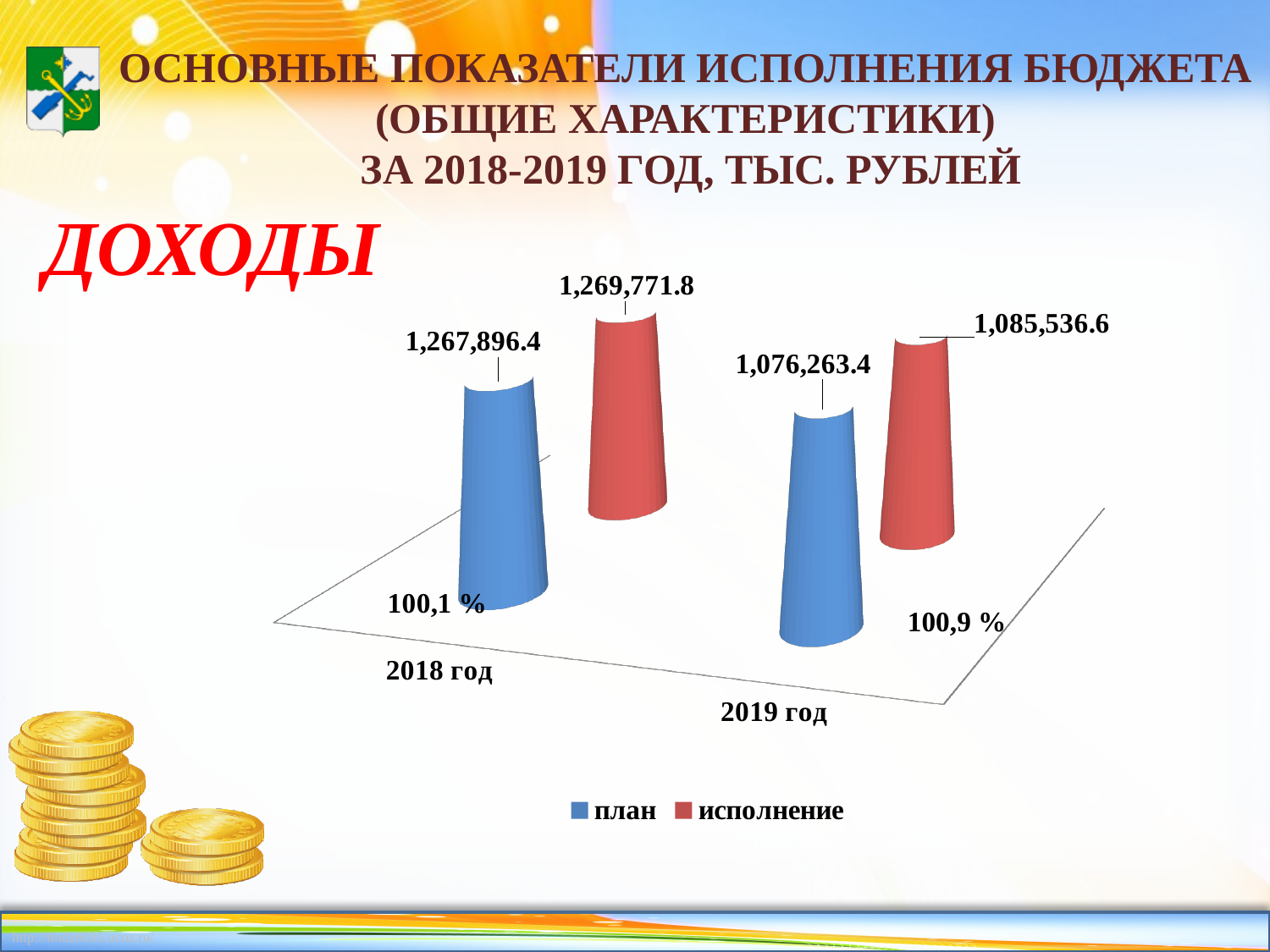
What is the value for исполнение in 2018 год? 1,269,771.8 Which series has the lowest value on the chart, and in which year? план, 2019 год What is the value for исполнение in 2019 год? 1,085,536.6 Which is larger in 2018 год, план or исполнение? исполнение How many series does the legend list? 2 What is the value for план in 2018 год? 1,267,896.4 What is the difference between the план values for 2018 год and 2019 год? 191,633.0 Do the исполнение values rise or fall from 2018 год to 2019 год? fall What is the difference between исполнение and план in 2019 год? 9,273.2 What percentage is shown for 2019 год? 100,9 % What kind of chart is shown on the slide? bar chart What is the value for план in 2019 год? 1,076,263.4